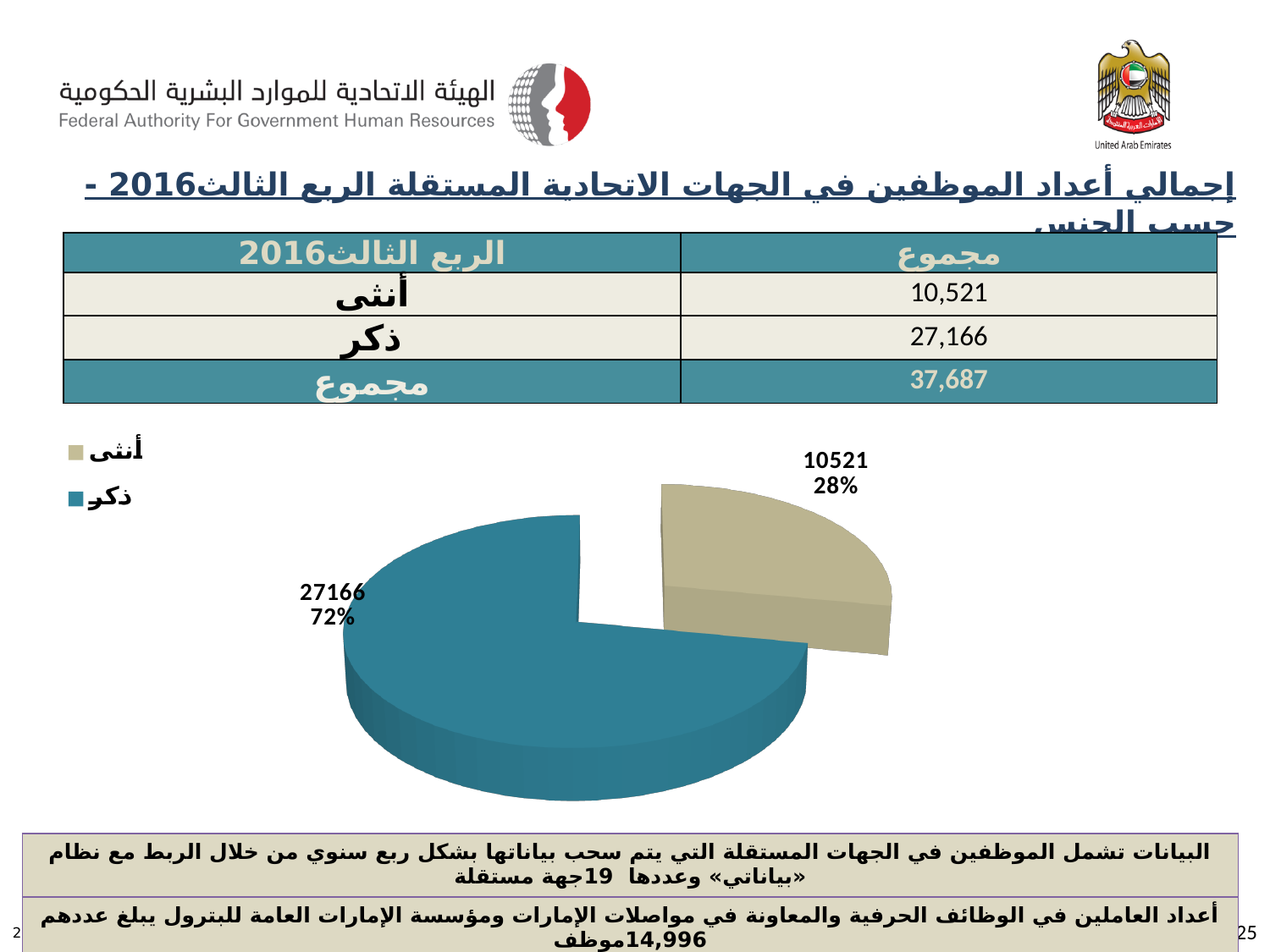
Which legend entry is shown in the beige/tan colour in the pie chart? أنثى How many slices does the pie chart have? 2 How many entries does the pie chart's legend list? 2 What value is labelled on the pie slice for ذكر? 27166 What kind of chart is shown on the slide? pie chart What is the difference between the ذكر value and the أنثى value in the pie chart? 16645 What value is labelled on the pie slice for أنثى? 10521 Which is larger in the pie chart, the value for ذكر or the value for أنثى? ذكر What percentage share of the pie does the أنثى slice have? 28% Which slice of the pie chart is the smallest? أنثى What percentage share of the pie does the ذكر slice have? 72% Which slice of the pie chart is the largest? ذكر